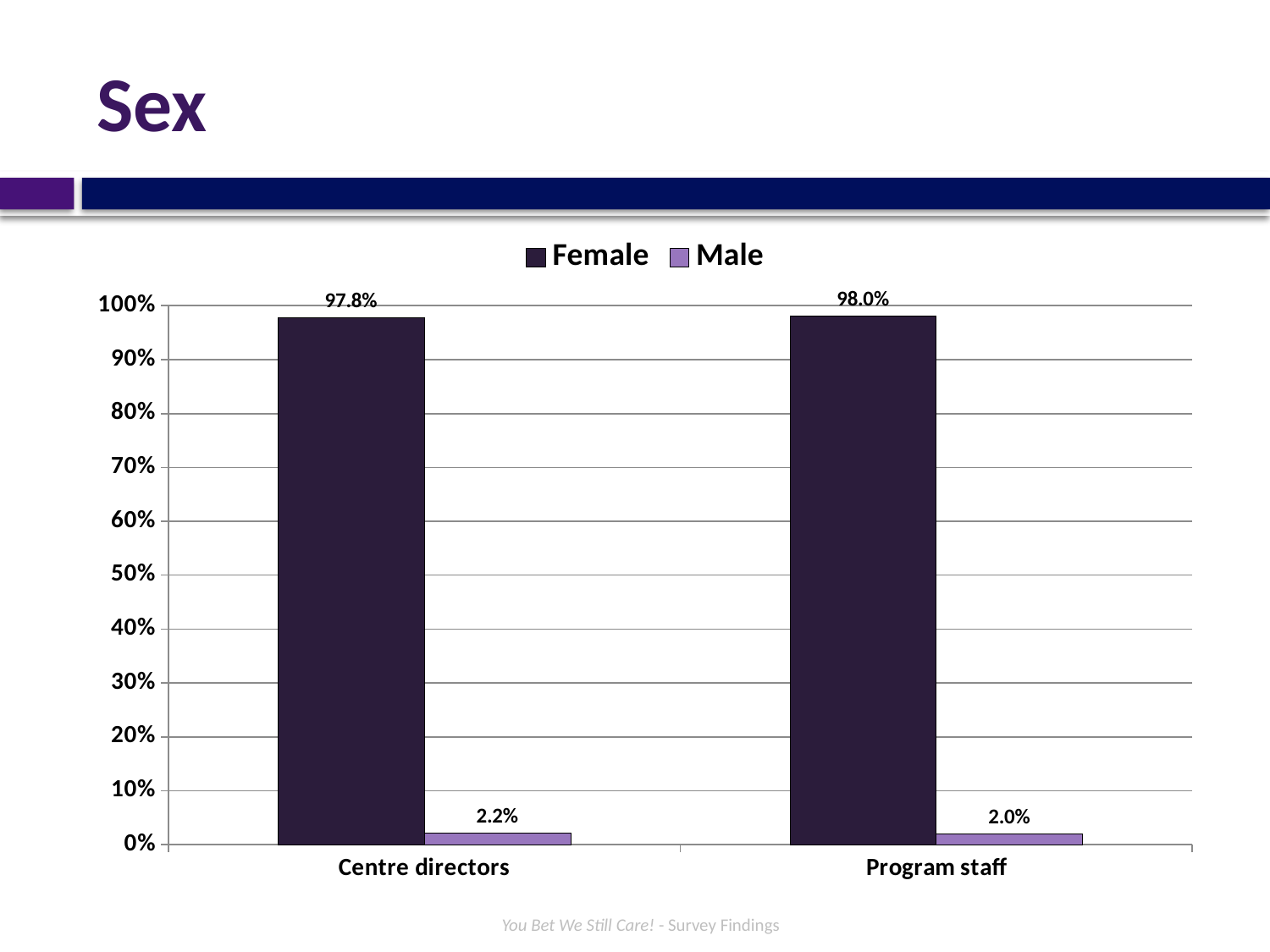
What is the difference between the Female and Male percentages for Centre directors? 95.6% How many categories are shown on the x axis? 2 How many series does the legend list? 2 What percentage of Program staff are Female? 98.0% Which category has the lower Male percentage? Program staff Which category has the higher Female percentage? Program staff What percentage of Program staff are Male? 2.0% What percentage of Centre directors are Female? 97.8% Is the Female value for Centre directors greater or less than 90%? greater What percentage of Centre directors are Male? 2.2% What are the two series named in the legend? Female and Male What kind of chart is shown on the slide? Bar chart